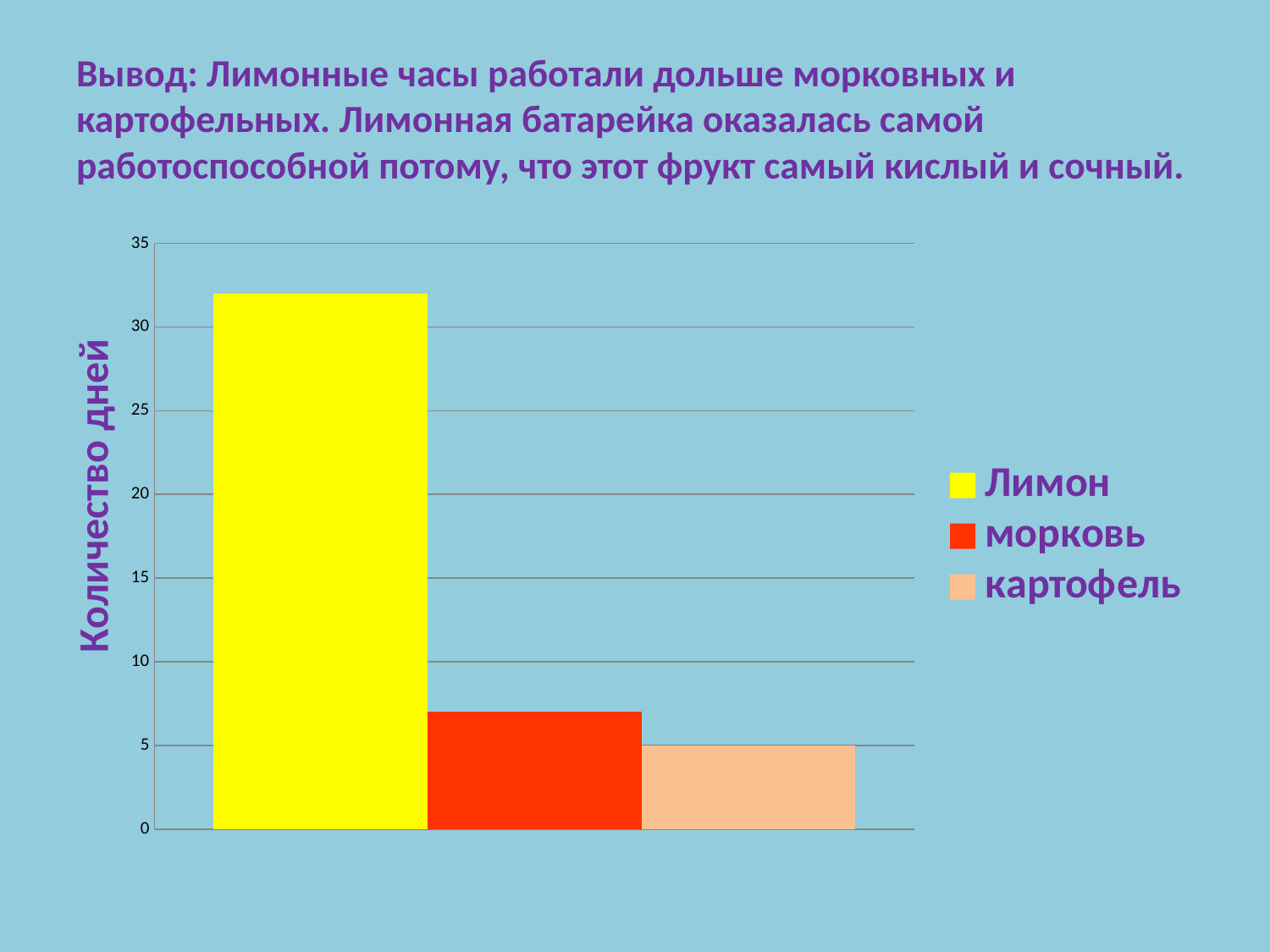
Is the value for морковь greater or less than 5? greater What is the title of the vertical axis? Количество дней Which series has the lowest value? картофель Which is larger, the value for Лимон or the value for морковь? Лимон Is the value for Лимон greater or less than 30? greater What kind of chart is shown on the slide? bar chart What is the value for картофель? 5 Is the value for морковь greater or less than 10? less Which series has the highest value? Лимон What colour is the bar for Лимон? yellow Which is larger, the value for морковь or the value for картофель? морковь How many series does the legend list? 3